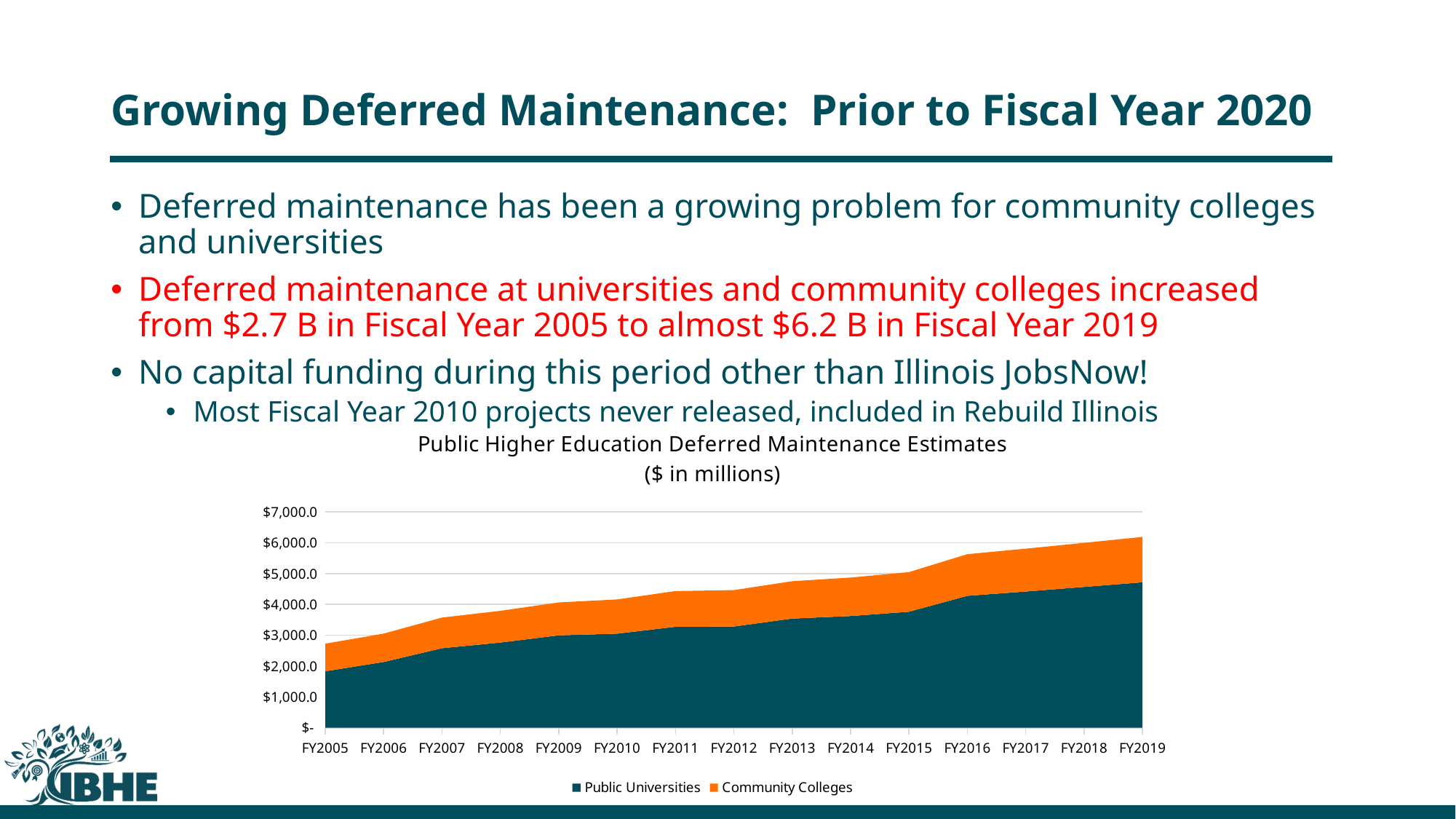
Is the value for Public Universities in FY2005 greater or less than $2,000.0? less Is the combined total for FY2016 greater or less than $5,000.0? greater How many series does the legend list? 2 Is the combined total for FY2005 greater or less than $3,000.0? less Which fiscal year has the lowest total deferred maintenance estimate? FY2005 Which fiscal year has the highest total deferred maintenance estimate? FY2019 Do the total deferred maintenance estimates rise or fall from FY2005 to FY2019? Rise What is the title of the chart? Public Higher Education Deferred Maintenance Estimates ($ in millions) How many fiscal years are shown on the x axis? 15 In FY2019, which series is larger: Public Universities or Community Colleges? Public Universities What kind of chart is shown on the slide? Stacked area chart